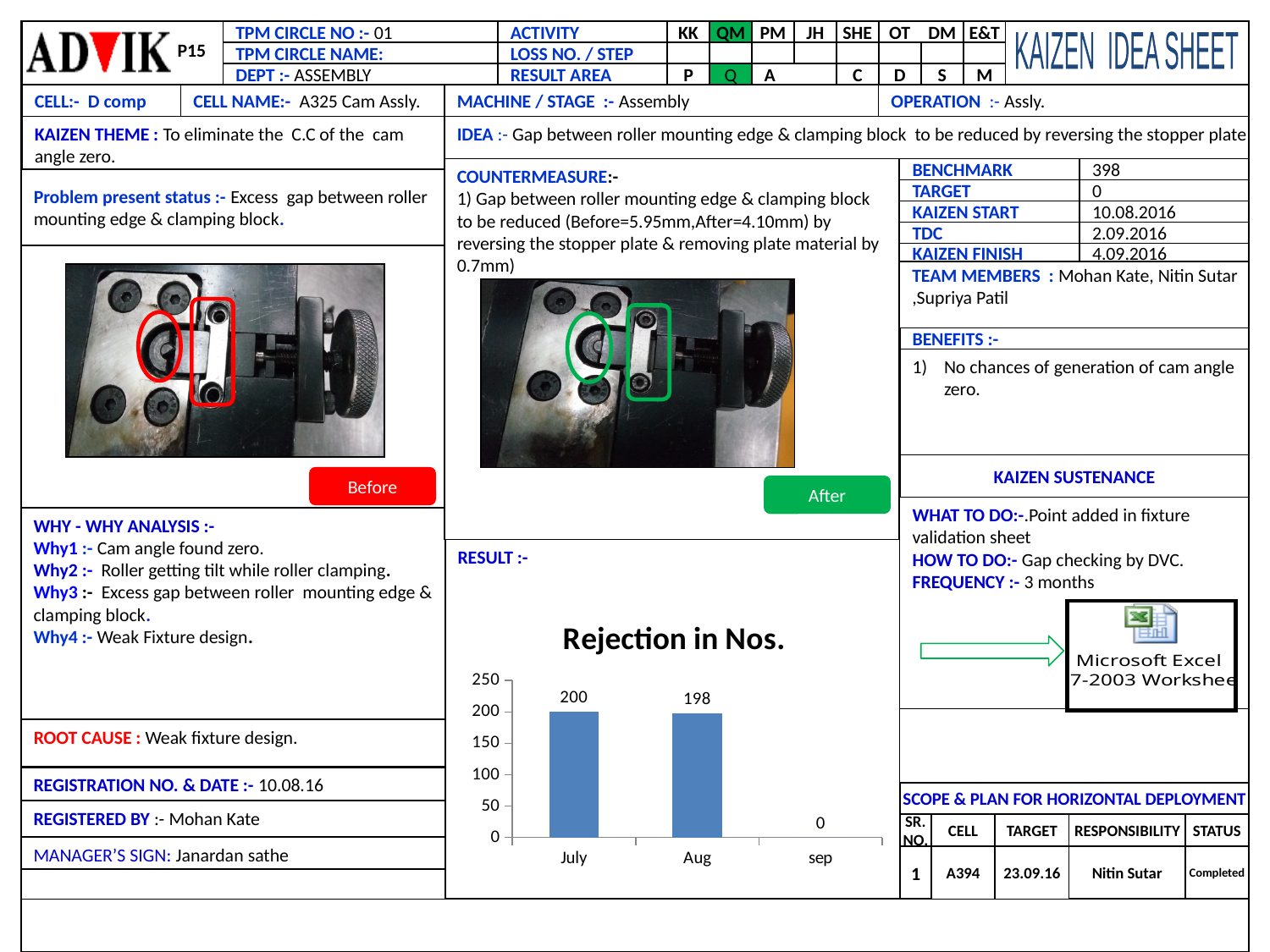
What is the difference between the rejection values for July and Aug? 2 What is the title of the chart on the slide? Rejection in Nos. Do the rejection values rise or fall from July to sep? fall What is the difference between the rejection values for Aug and sep? 198 Is the rejection value for Aug greater or less than 150? greater What is the rejection value for Aug? 198 Which month has the lowest rejection value? sep What is the rejection value for sep? 0 How many months are shown on the x axis of the chart? 3 What kind of chart is shown under RESULT? bar chart What is the rejection value for July? 200 Which month has the highest rejection value? July